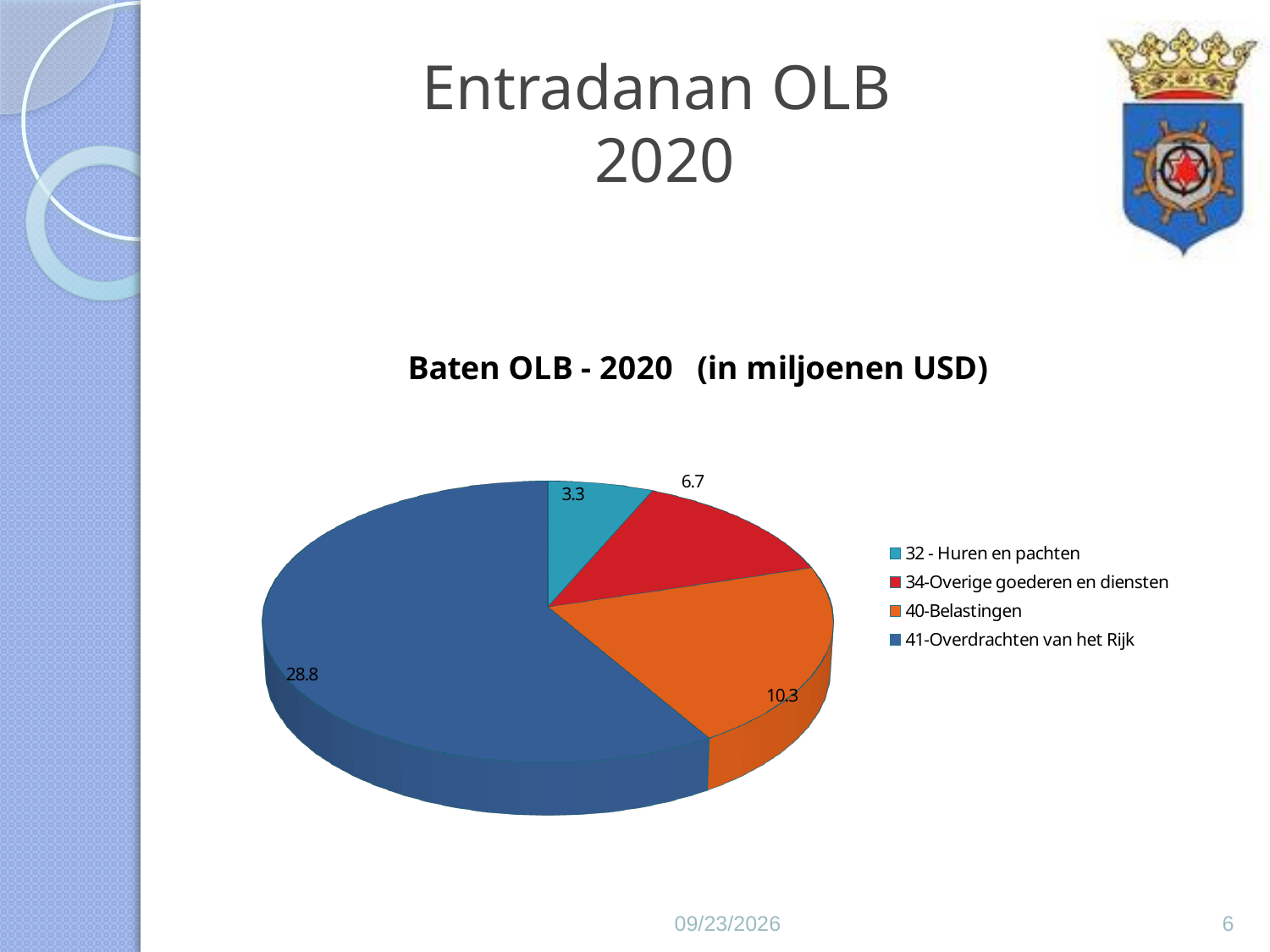
What is the value for 41-Overdrachten van het Rijk? 28.8 What kind of chart is shown on the slide? Pie chart What is the value for 34-Overige goederen en diensten? 6.7 How many categories does the legend list? 4 Which category has the largest slice of the pie? 41-Overdrachten van het Rijk What is the total of all four slices in the pie? 49.1 What is the value for 40-Belastingen? 10.3 What is the value for 32 - Huren en pachten? 3.3 What is the title of the chart? Baten OLB - 2020 (in miljoenen USD) Which category has the smallest slice of the pie? 32 - Huren en pachten Which is larger, the value for 40-Belastingen or the value for 34-Overige goederen en diensten? 40-Belastingen What is the difference between the values for 41-Overdrachten van het Rijk and 40-Belastingen? 18.5